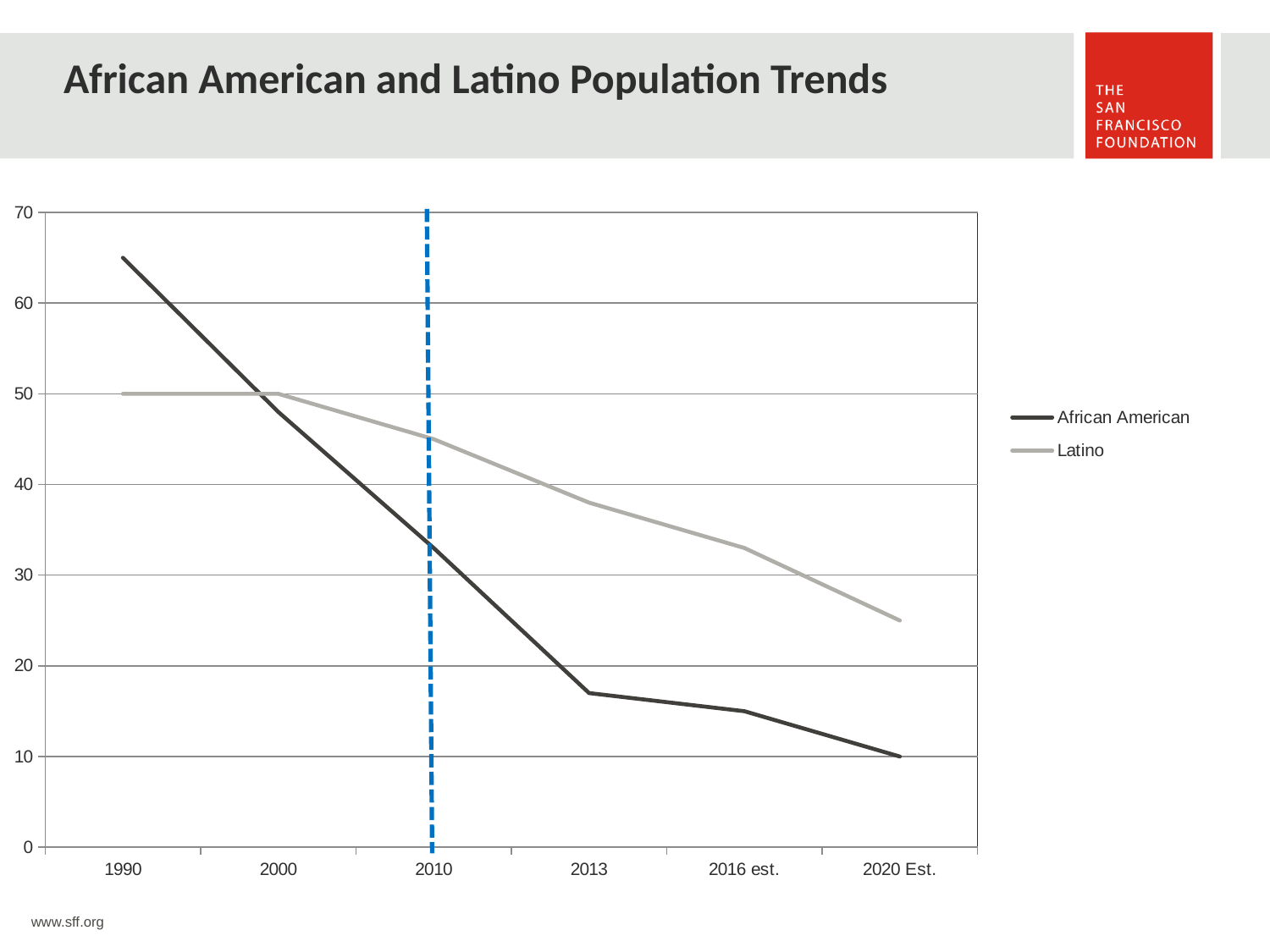
What is the Latino value in 1990? 50 Is the African American value in 1990 greater or less than 60? greater Is the Latino value for 2020 Est. greater or less than 30? less In 2013, which series has the higher value, African American or Latino? Latino Is the African American value in 2013 greater or less than 20? less How many time points are shown along the x axis? 6 Does the African American line rise or fall from 1990 to 2020 Est.? fall What are the two entries in the legend? African American, Latino In which year is the African American series at its highest? 1990 What is the African American value for 2020 Est.? 10 What kind of chart is shown on the slide? line chart How many series does the legend list? 2